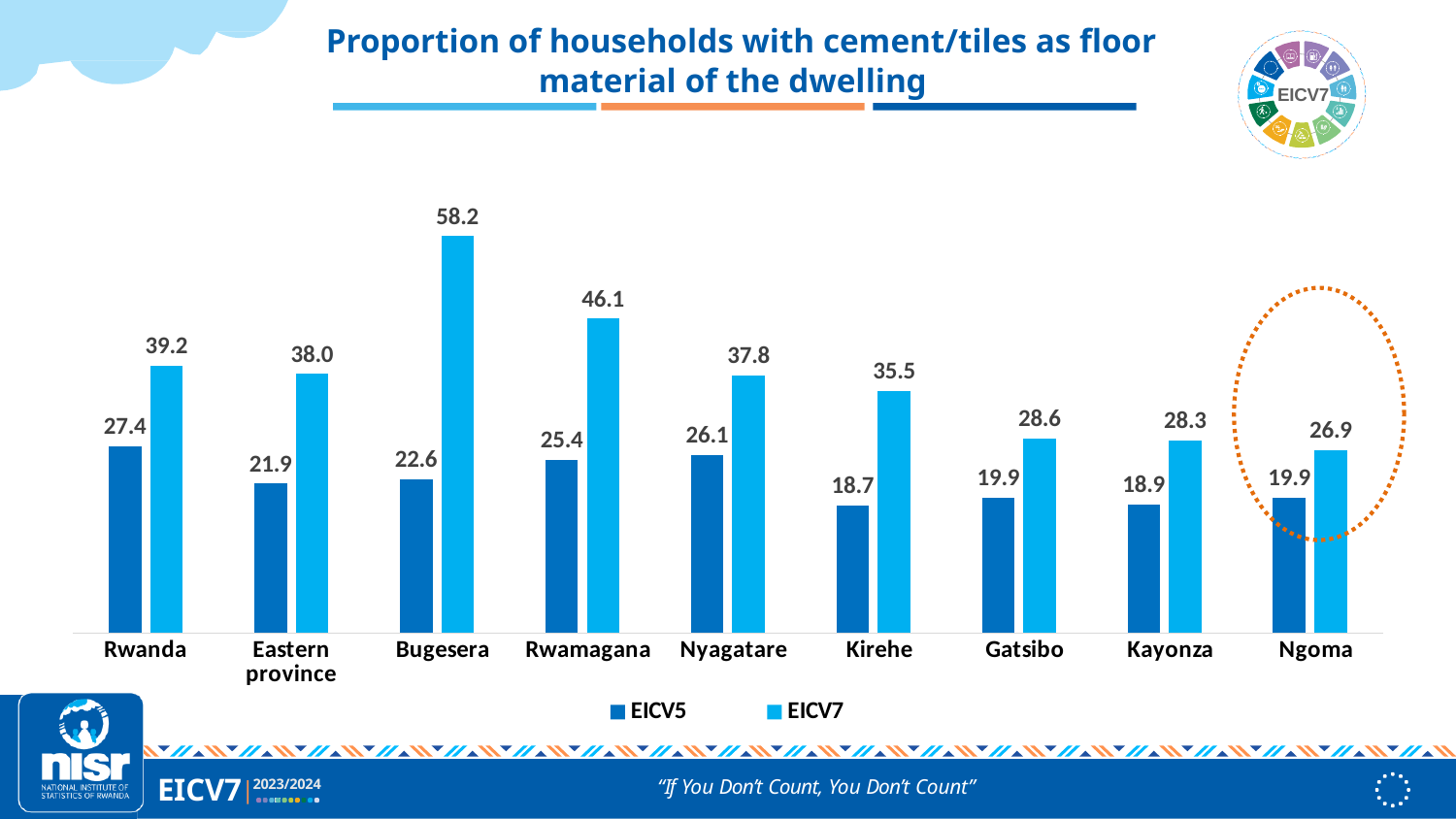
What is the EICV5 value for Rwanda? 27.4 What is the EICV7 value for Bugesera? 58.2 Which is larger, the EICV7 value for Kirehe or the EICV7 value for Nyagatare? Nyagatare What is the difference between the EICV7 and EICV5 values for Bugesera? 35.6 Which category is highlighted with a dotted orange circle? Ngoma What is the EICV7 value for Ngoma? 26.9 What is the difference between the EICV7 values for Rwanda and Eastern province? 1.2 How many series does the legend list? 2 Which category has the highest EICV7 value? Bugesera Which category has the lowest EICV5 value? Kirehe How many categories are shown on the x axis? 9 What kind of chart is shown on the slide? Bar chart